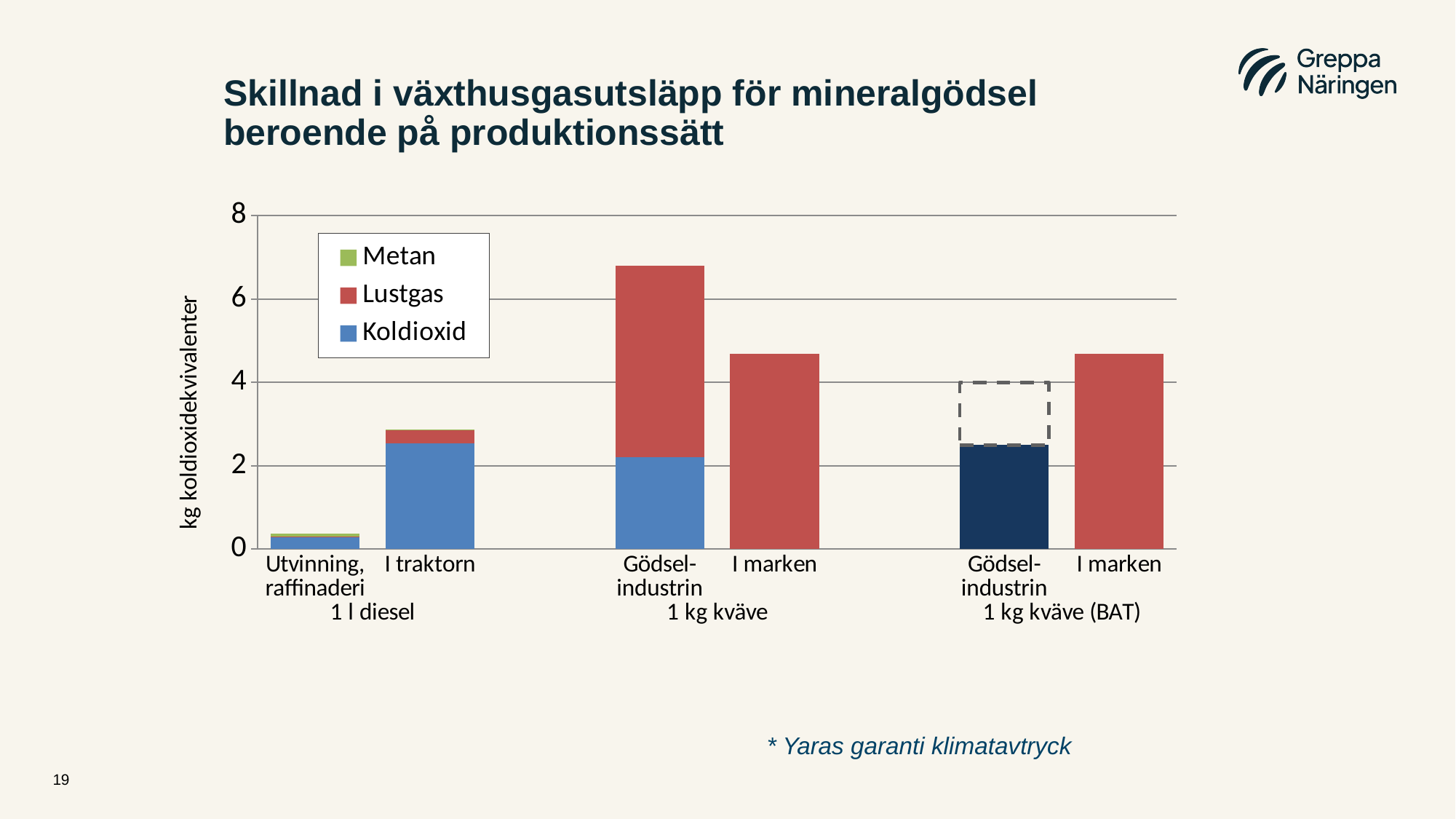
How many bars are plotted in the chart? 6 Which bar is the highest in the chart? Gödselindustrin (1 kg kväve) How many series does the legend list? 3 Which is larger, the bar for I traktorn or the bar for Gödselindustrin under 1 kg kväve? Gödselindustrin (1 kg kväve) Which series are listed in the legend? Metan, Lustgas, Koldioxid Which bar is the lowest in the chart? Utvinning, raffinaderi What kind of chart is shown on the slide? Stacked bar chart Is the value for I marken under 1 kg kväve greater or less than 4? greater What is the label of the vertical axis? kg koldioxidekvivalenter Is the total value for I traktorn greater or less than 4? less Is the total value for Gödselindustrin under 1 kg kväve greater or less than 6? greater